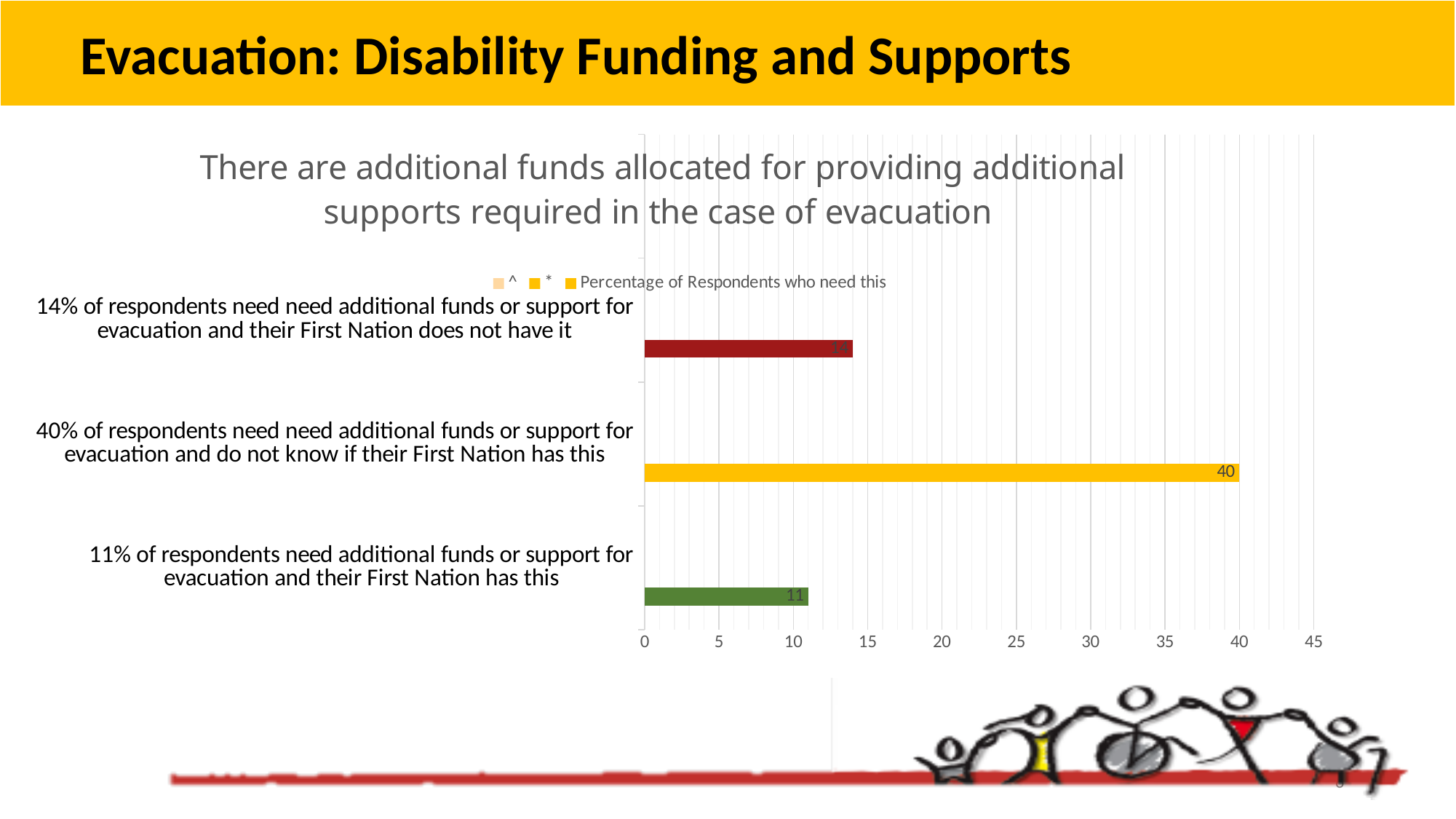
Which category has the lowest value? 11% of respondents need additional funds or support for evacuation and their First Nation has this How many entries does the chart legend list? 3 Is the value for respondents who do not know if their First Nation has this greater or less than 35? greater What is the value for respondents who need additional funds or support for evacuation and their First Nation does not have it? 14 What is the difference between the value for those who do not know if their First Nation has this and the value for those whose First Nation does not have it? 26 Which category has the highest value? 40% of respondents need need additional funds or support for evacuation and do not know if their First Nation has this Which is larger: the value for those whose First Nation does not have it, or the value for those whose First Nation has this? their First Nation does not have it What type of chart is shown on the slide? bar chart How many categories (bars) are plotted in the chart? 3 What is the value for respondents who need additional funds or support for evacuation and their First Nation has this? 11 What is the value for respondents who need additional funds or support for evacuation and do not know if their First Nation has this? 40 What is the title of the chart? There are additional funds allocated for providing additional supports required in the case of evacuation